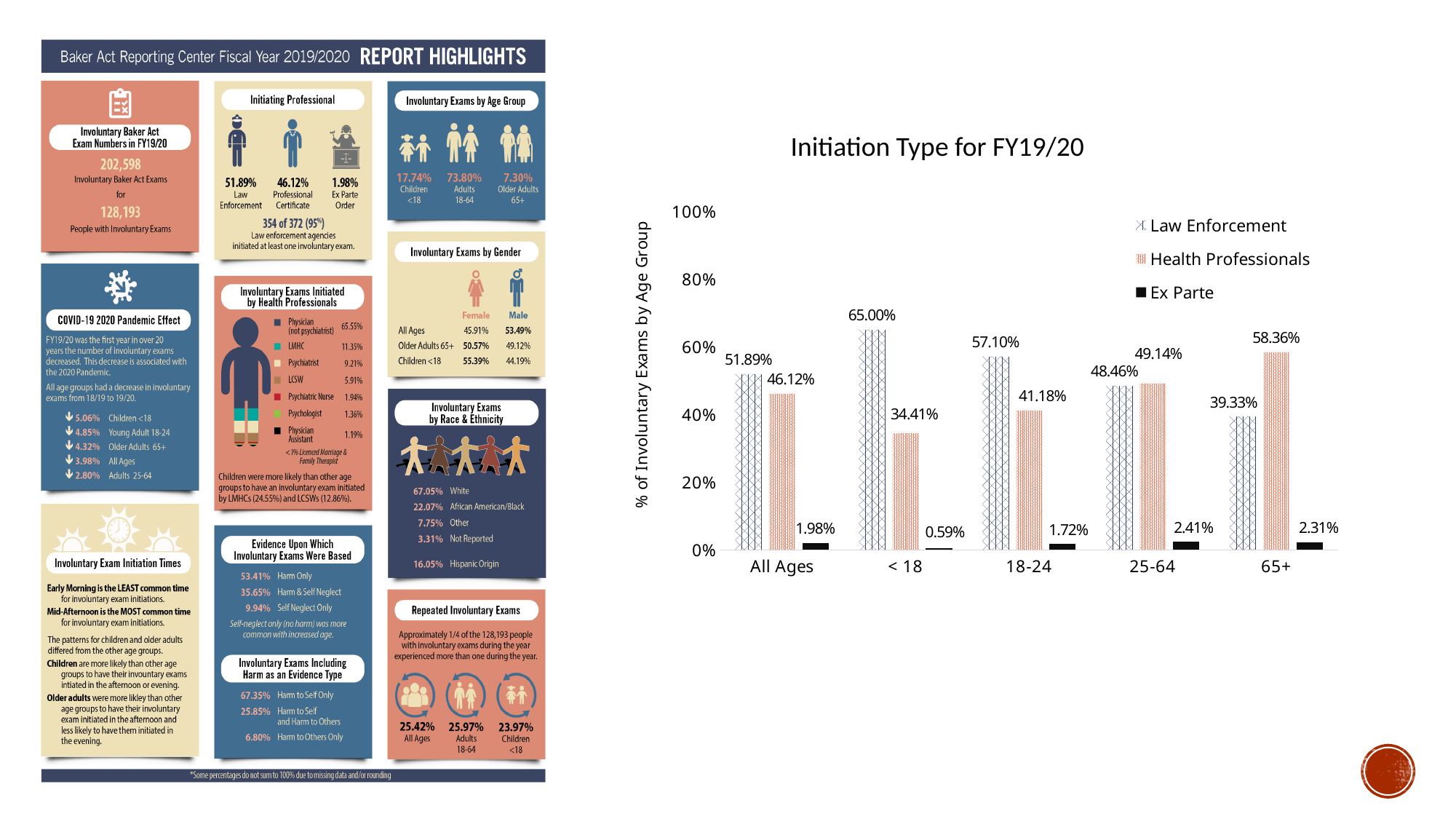
What is the Law Enforcement value for the < 18 age group? 65.00% What kind of chart is shown? Bar chart What is the Ex Parte value for the 25-64 age group? 2.41% Which age group has the lowest Health Professionals value? < 18 Which age group has the highest Law Enforcement value? < 18 How many series does the legend list? 3 For the 65+ age group, which is larger: Law Enforcement or Health Professionals? Health Professionals What is the difference between the Law Enforcement and Health Professionals values for the 18-24 age group? 15.92% What is the title of the chart? Initiation Type for FY19/20 What is the Health Professionals value for the 65+ age group? 58.36% How many age group categories are shown on the x axis? 5 Which age group has the lowest Ex Parte value? < 18